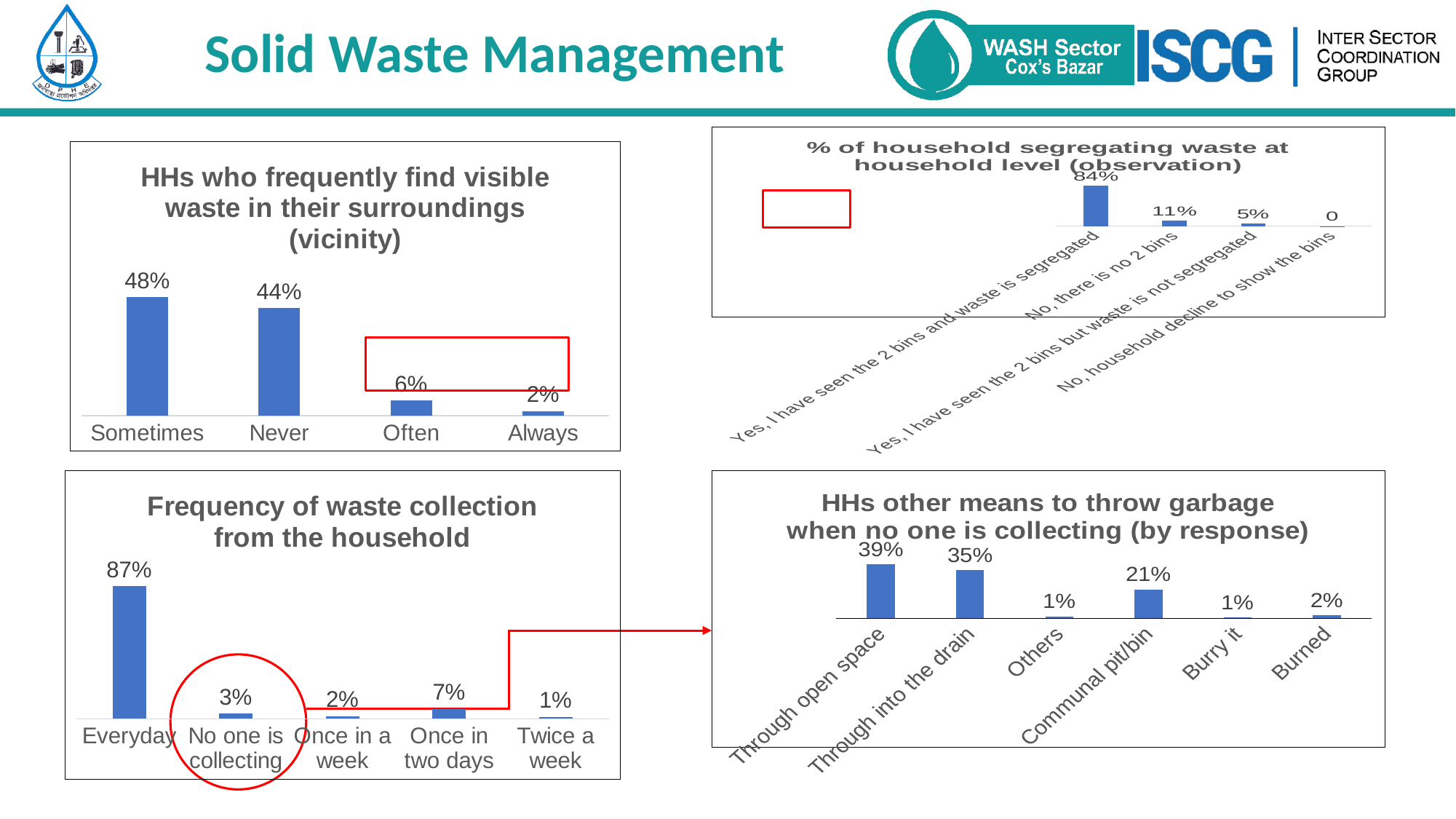
In the chart 'HHs who frequently find visible waste in their surroundings (vicinity)', which category has the lowest value? Always In the chart 'HHs who frequently find visible waste in their surroundings (vicinity)', what is the value for Sometimes? 48% In the chart '% of household segregating waste at household level (observation)', which category has the highest value? Yes, I have seen the 2 bins and waste is segregated How many categories are shown in the chart 'Frequency of waste collection from the household'? 5 In the chart 'HHs other means to throw garbage when no one is collecting (by response)', what is the difference between Through open space and Through into the drain? 4% In the chart 'HHs who frequently find visible waste in their surroundings (vicinity)', what is the difference between Sometimes and Never? 4% In the chart 'HHs other means to throw garbage when no one is collecting (by response)', what is the value for Communal pit/bin? 21% What type of chart is 'HHs other means to throw garbage when no one is collecting (by response)'? Bar chart In the chart 'Frequency of waste collection from the household', what is the value for Everyday? 87% In the chart '% of household segregating waste at household level (observation)', what is the value for 'No, there is no 2 bins'? 11% In the chart 'Frequency of waste collection from the household', which is larger: Once in two days or Once in a week? Once in two days How many categories are shown in the chart '% of household segregating waste at household level (observation)'? 4